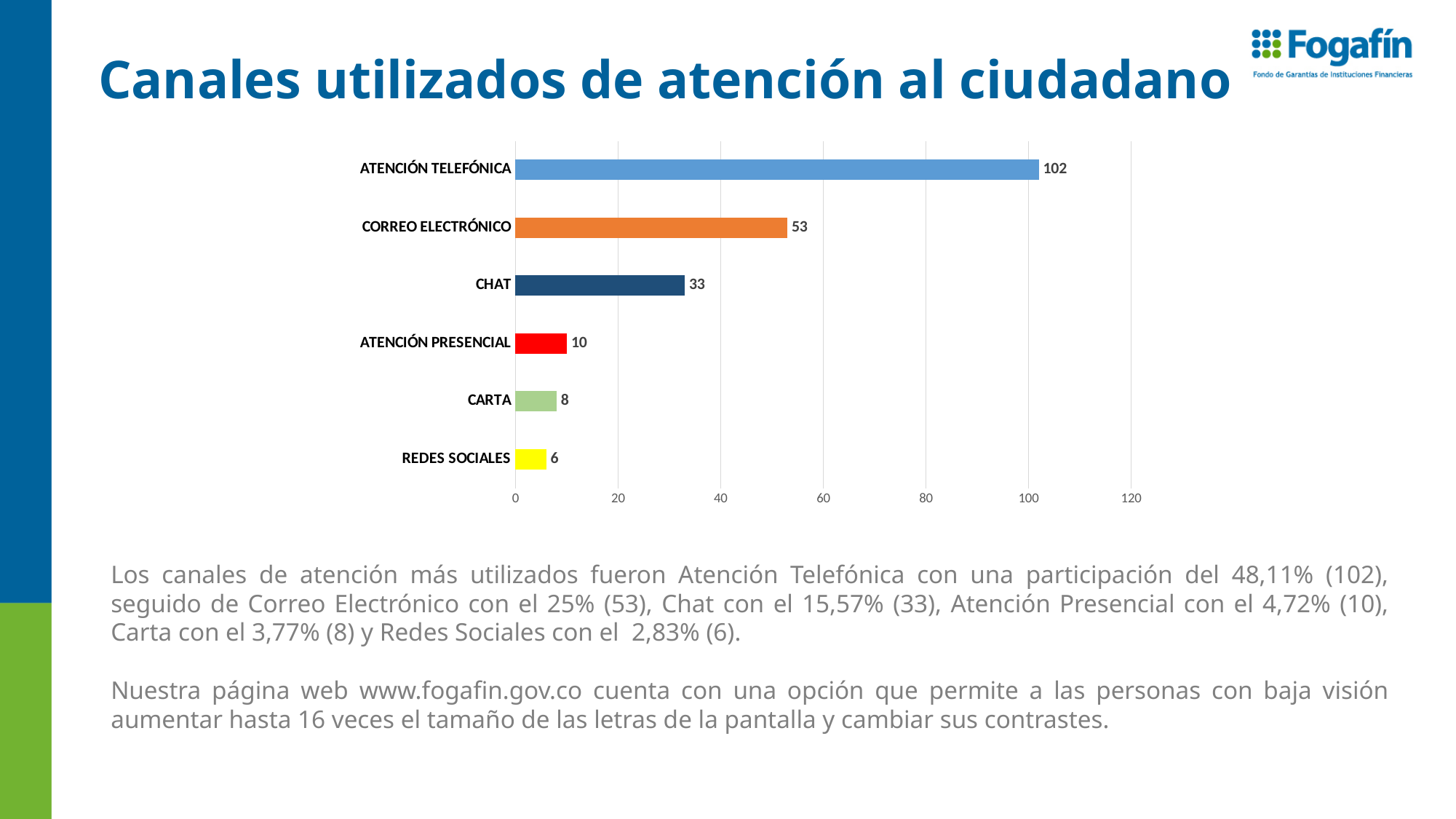
Which channel has the highest value? ATENCIÓN TELEFÓNICA Which is larger, the value for ATENCIÓN PRESENCIAL or the value for CARTA? ATENCIÓN PRESENCIAL What is the value for ATENCIÓN TELEFÓNICA? 102 Which channel has the lowest value? REDES SOCIALES What kind of chart is shown on the slide? bar chart What is the value for CARTA? 8 What colour is the bar for REDES SOCIALES? yellow What is the difference between the values for ATENCIÓN TELEFÓNICA and CORREO ELECTRÓNICO? 49 Is the value for CHAT greater or less than 40? less What is the value for CHAT? 33 How many channels are shown in the chart? 6 What is the value for CORREO ELECTRÓNICO? 53